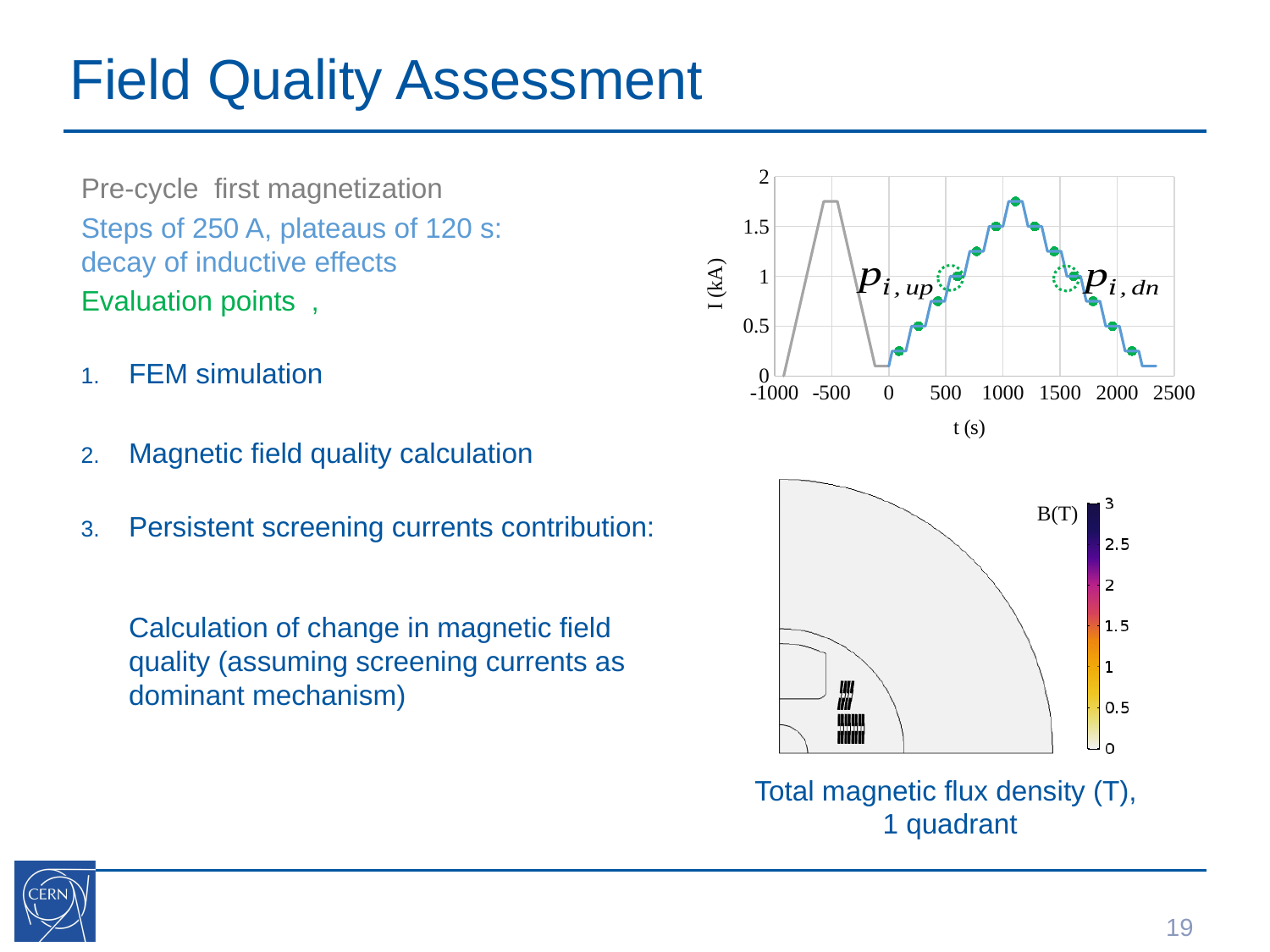
In the upper chart, what is the highest tick value shown on the t (s) axis? 2500 In the upper chart, does the blue current curve rise or fall between t = 0 s and t = 1000 s? rise In the lower field map, what is the minimum value shown on the B(T) colour bar? 0 What is the caption under the lower field map? Total magnetic flux density (T), 1 quadrant In the upper chart, what is the label of the y axis? I (kA) In the lower field map, what is the maximum value shown on the B(T) colour bar? 3 In the upper chart, is the peak of the grey pre-cycle curve greater or less than 1 kA? greater In the upper chart, is the peak value of the blue stepped current curve greater or less than 2 kA? less In the upper chart, is the peak value of the blue stepped current curve greater or less than 1.5 kA? greater In the upper chart, what is the lowest tick value shown on the t (s) axis? -1000 In the upper chart, does the blue current curve rise or fall between t = 1500 s and t = 2000 s? fall What kind of chart is the upper chart of current versus time? line chart